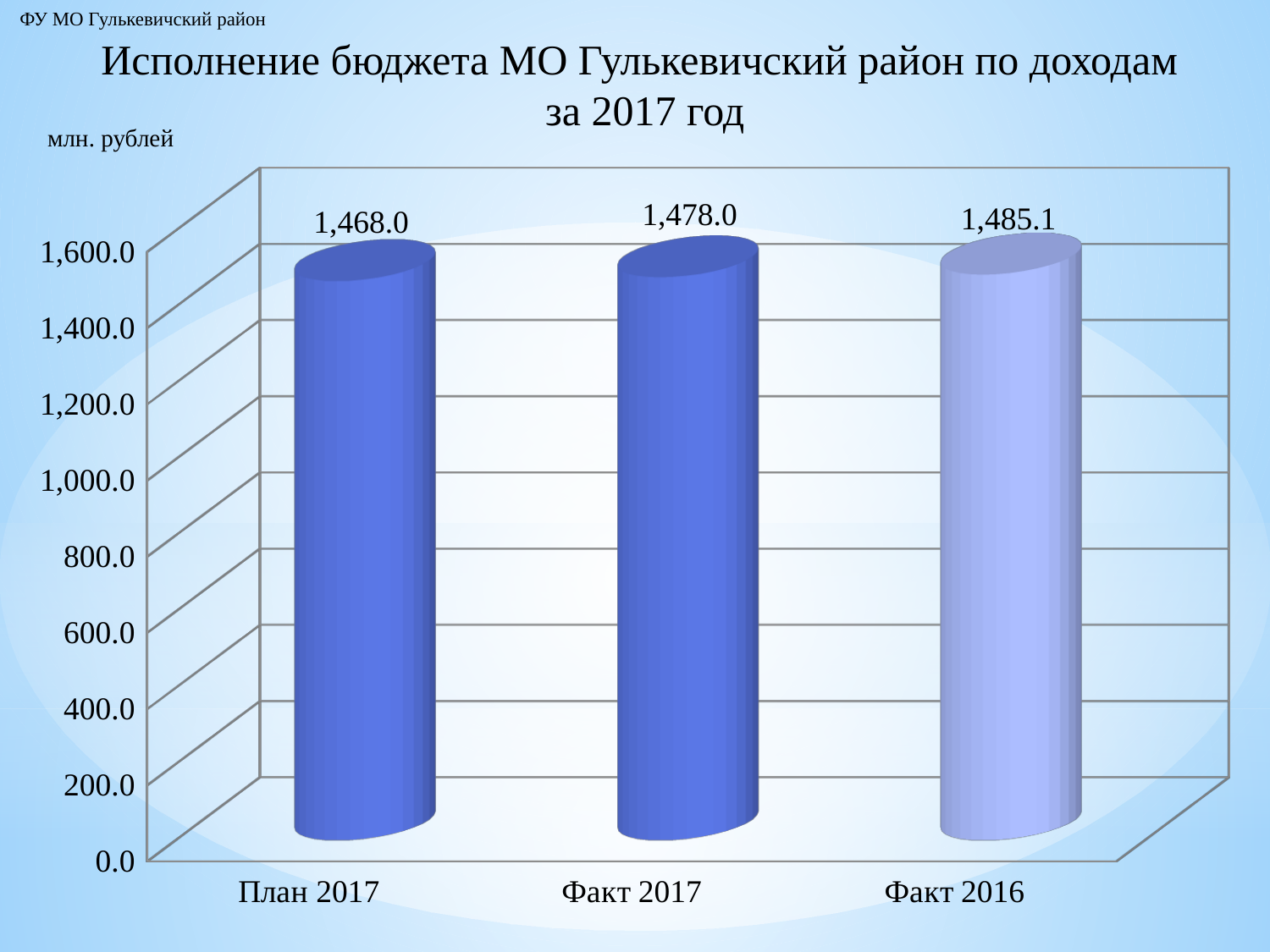
Which category has the lowest value? План 2017 What kind of chart is shown on the slide? bar chart Which category has the highest value? Факт 2016 What is the value for План 2017? 1,468.0 What is the difference between Факт 2017 and План 2017? 10.0 What is the value for Факт 2016? 1,485.1 Which is larger, the value for Факт 2017 or the value for План 2017? Факт 2017 What unit of measurement is indicated for the chart values? млн. рублей How many categories are shown on the chart? 3 What is the difference between Факт 2016 and Факт 2017? 7.1 What is the value for Факт 2017? 1,478.0 Is the value for План 2017 greater or less than 1,400.0? greater